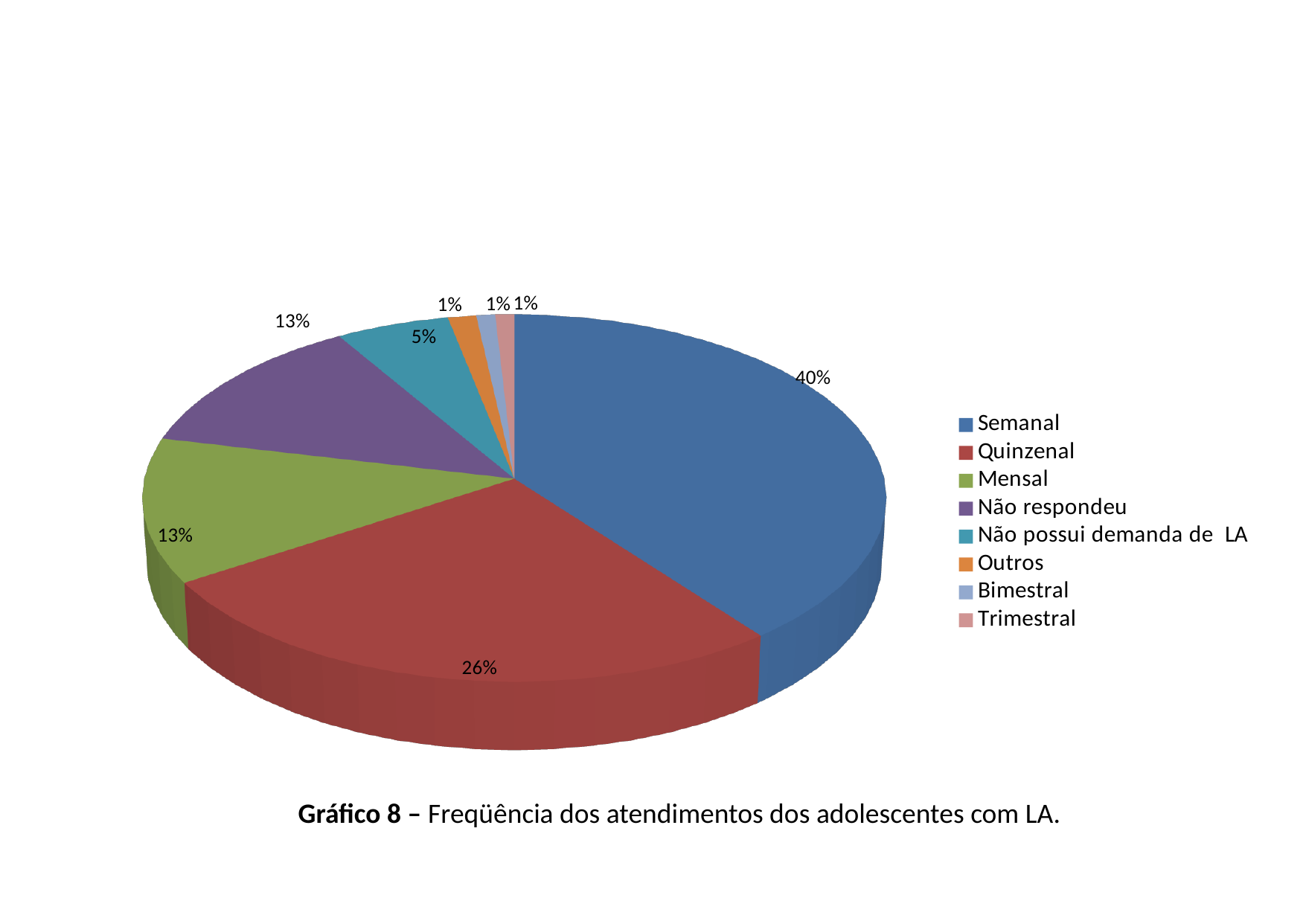
What kind of chart is shown on the slide? Pie chart What is the difference between the Quinzenal and Mensal shares? 13% Which is larger, the share for Não respondeu or the share for Não possui demanda de LA? Não respondeu What is the difference between the Semanal and Quinzenal shares? 14% What share of the pie does Quinzenal represent? 26% What share of the pie does Semanal represent? 40% What is the value shown for Não possui demanda de LA? 5% What is the caption of the chart? Gráfico 8 – Freqüência dos atendimentos dos adolescentes com LA. What is the value shown for Outros? 1% How many categories does the legend list? 8 What is the value shown for Mensal? 13% Which category has the largest slice of the pie? Semanal